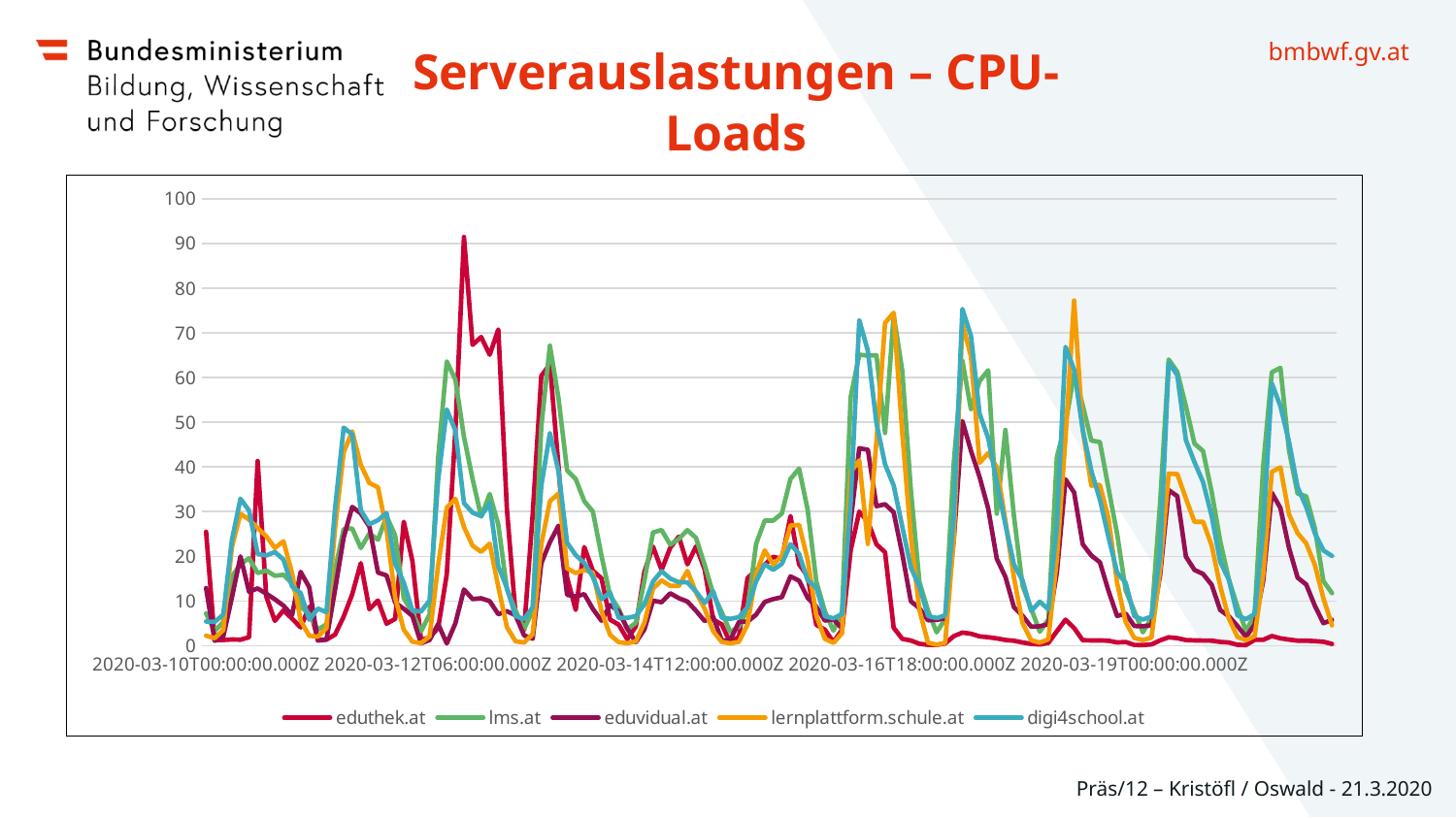
Is the value for eduthek.at at the far right end of the chart greater or less than 10? less What is the title of the chart on the slide? Serverauslastungen – CPU-Loads Which colour is used for the eduthek.at series? red Which series reaches the highest CPU load value anywhere in the chart? eduthek.at Is the highest value reached by eduvidual.at greater or less than 60? less Is the highest peak of lernplattform.schule.at greater or less than 70? greater Does the eduthek.at series overall rise or fall from its peak around 2020-03-12 to the end of the period? fall What kind of chart is shown on the slide? line chart Which series has the higher maximum peak, eduthek.at or digi4school.at? eduthek.at Which series has the higher maximum peak, lms.at or eduvidual.at? lms.at How many series does the legend list? 5